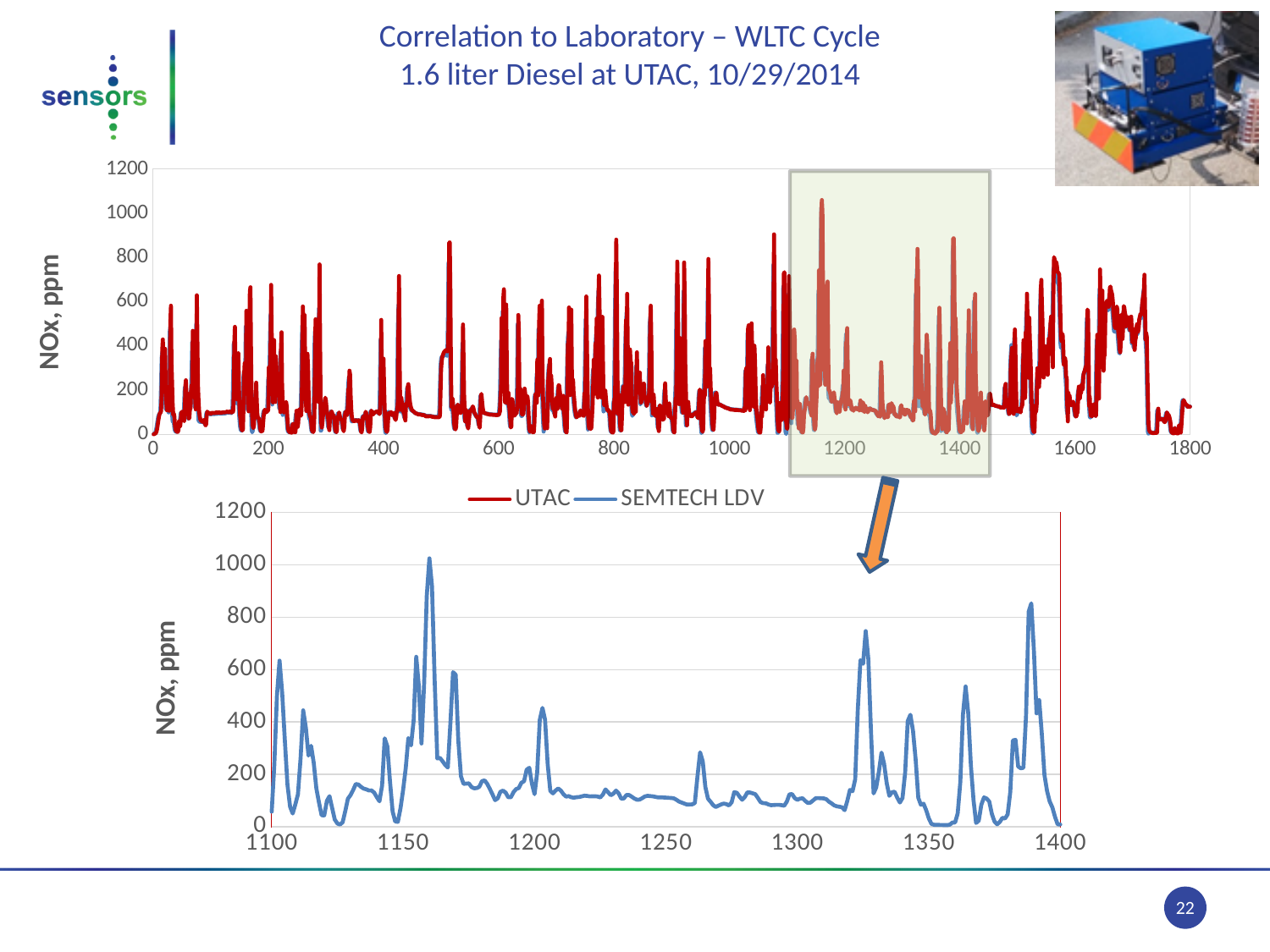
What kind of chart is the bottom chart on the slide? line chart In the bottom chart, is the value at around x = 1250 greater or less than 200? less In the bottom chart, is the peak value near x = 1160 greater or less than 800? greater What are the two series named in the legend below the top chart? UTAC and SEMTECH LDV In the bottom chart, is the peak value near x = 1390 greater or less than 600? greater What kind of chart is the top chart on the slide? line chart In the top chart, what colour is the UTAC line? red How many series does the legend below the top chart list? 2